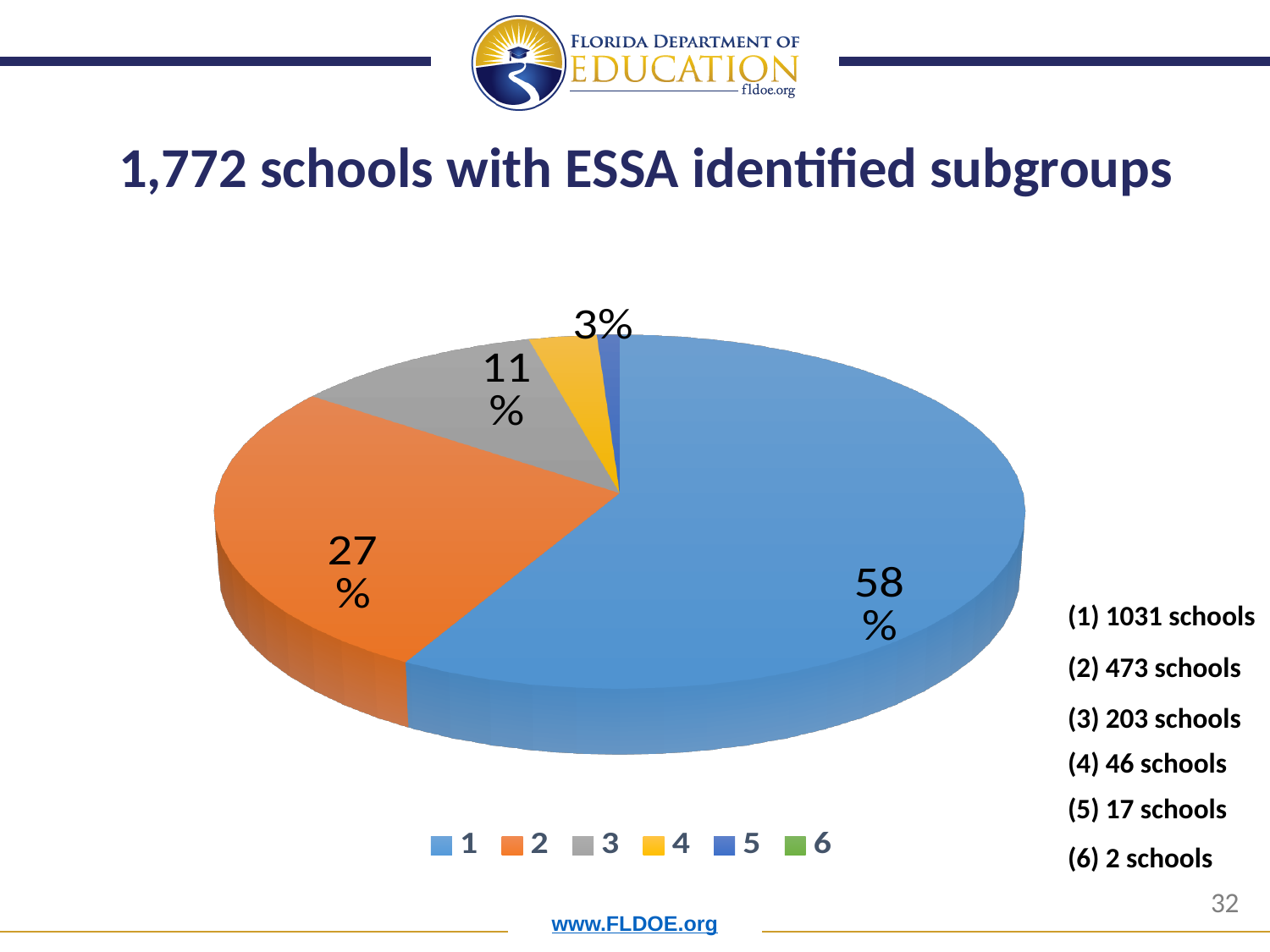
How many categories does the legend of the pie chart list? 6 What is the difference in percentage points between the shares of category 1 and category 2? 31% What percentage share is labelled for category 1 in the pie chart? 58% Is the share for category 1 greater or less than 50%? greater What percentage share is labelled for category 2 in the pie chart? 27% According to the text beside the chart, how many schools are in group (4)? 46 schools What kind of chart is shown on the slide? pie chart What colour is the slice for category 1 in the pie chart? blue Which category has the largest slice in the pie chart? 1 What percentage share is labelled for category 3 in the pie chart? 11% Which slice is larger in the pie chart, category 2 or category 3? 2 What is the title of the slide containing the pie chart? 1,772 schools with ESSA identified subgroups